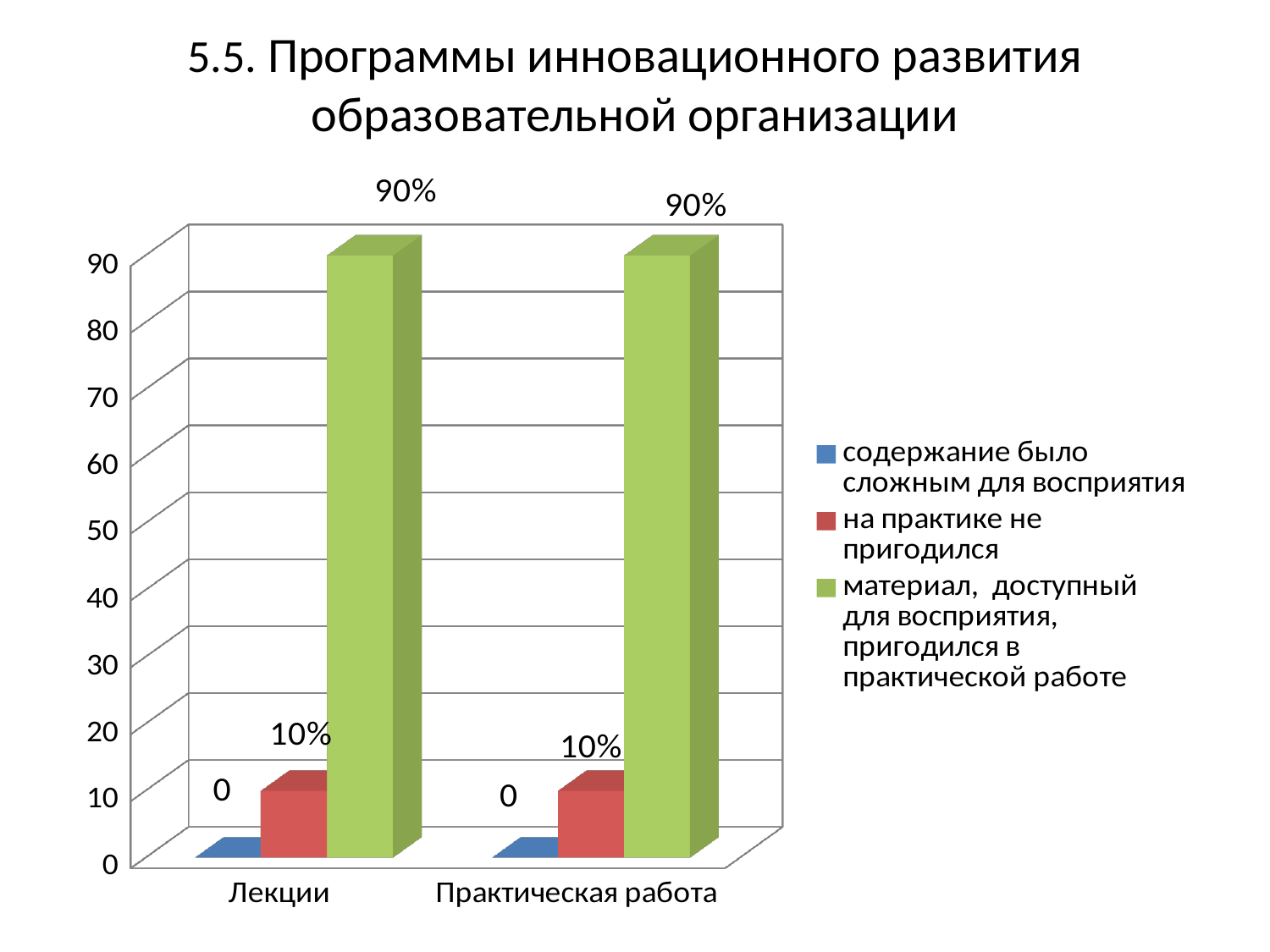
What is the difference between the "материал, доступный для восприятия, пригодился в практической работе" value and the "на практике не пригодился" value for Лекции? 80% What colour represents the series "на практике не пригодился"? red Which is larger for Практическая работа: "на практике не пригодился" or "содержание было сложным для восприятия"? на практике не пригодился What is the value for "материал, доступный для восприятия, пригодился в практической работе" for Лекции? 90% How many categories are shown on the x axis? 2 What is the value for "на практике не пригодился" for Практическая работа? 10% Which series has the lowest value for Лекции? содержание было сложным для восприятия What kind of chart is shown on the slide? bar chart How many series does the legend list? 3 What is the value for "содержание было сложным для восприятия" for Лекции? 0 What is the value for "на практике не пригодился" for Лекции? 10% Which series has the highest value for Практическая работа? материал, доступный для восприятия, пригодился в практической работе